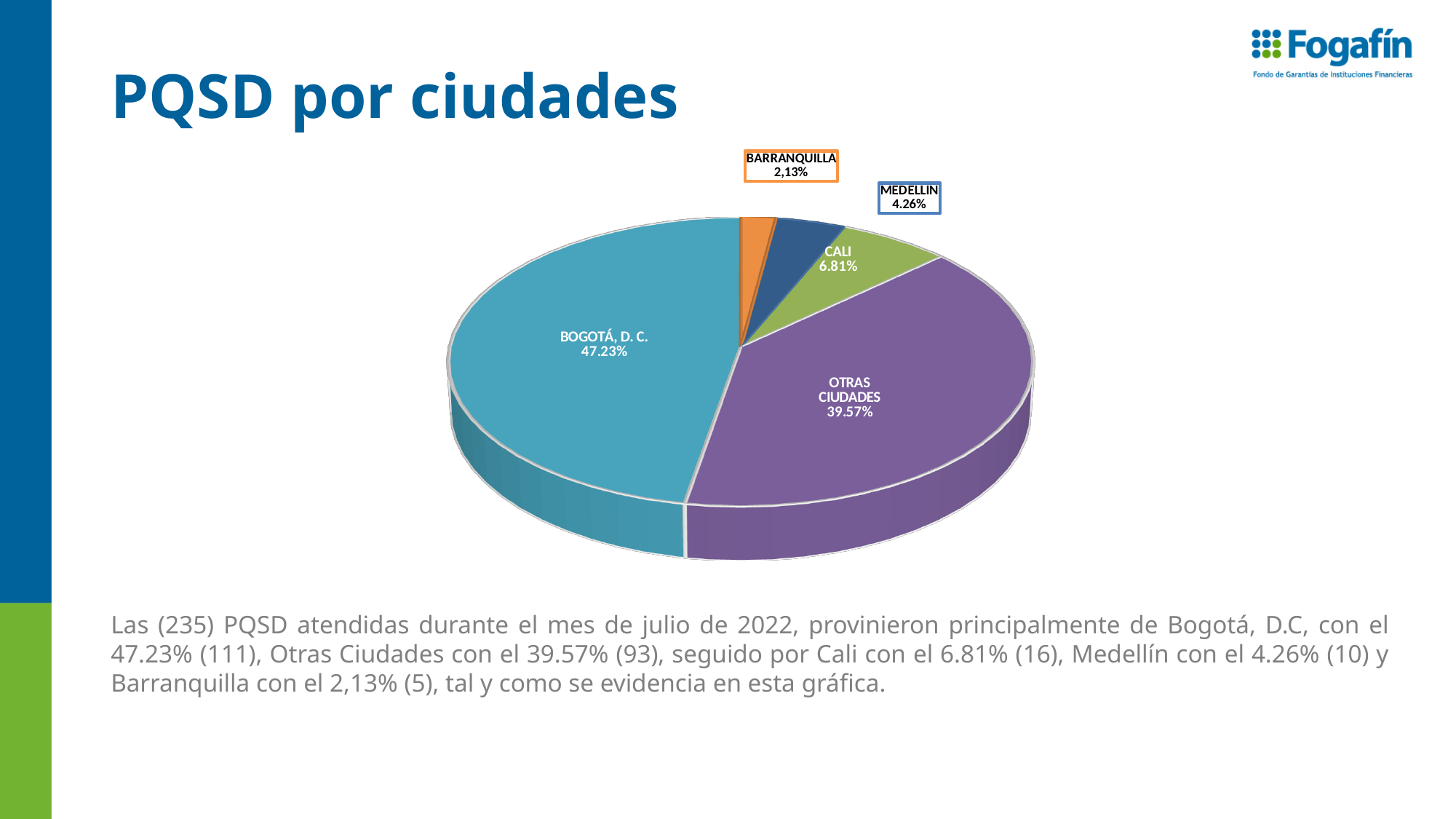
What kind of chart is shown on the slide? Pie chart What is the difference in percentage points between BOGOTÁ, D. C. and OTRAS CIUDADES? 7.66 What share of the pie does BOGOTÁ, D. C. represent? 47.23% Which city has the smallest slice of the pie? BARRANQUILLA What share of the pie does OTRAS CIUDADES represent? 39.57% How many slices does the pie chart have? 5 What is the value shown for CALI? 6.81% What is the value shown for MEDELLIN? 4.26% Which city has the largest slice of the pie? BOGOTÁ, D. C. What is the value shown for BARRANQUILLA? 2,13% Which is larger, the share for CALI or the share for MEDELLIN? CALI What is the title of the slide containing the chart? PQSD por ciudades